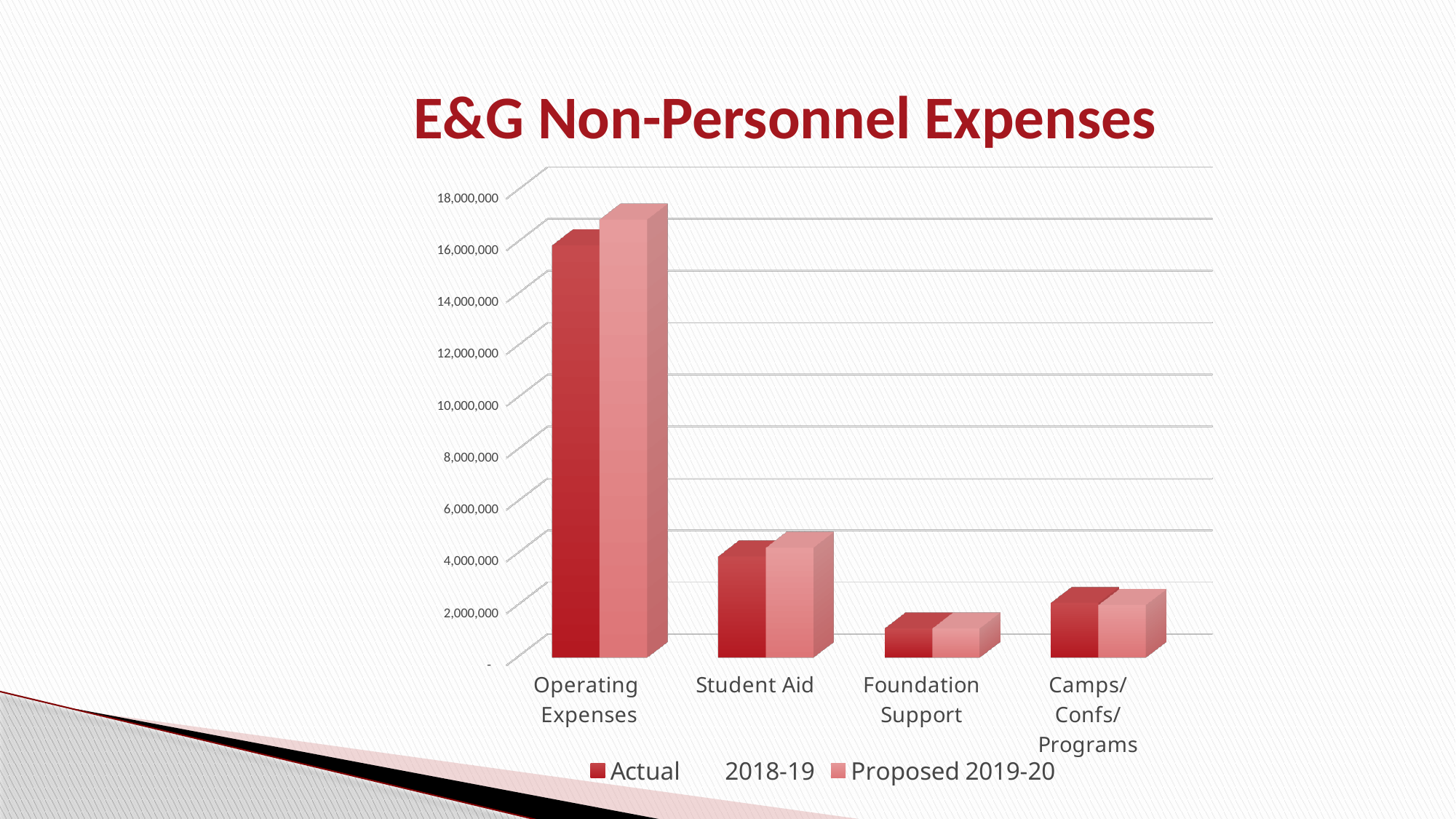
What is the title of the chart? E&G Non-Personnel Expenses Which category has the highest values in the chart? Operating Expenses Is the Actual 2018-19 value for Student Aid greater or less than 6,000,000? less Which category has the lowest values in the chart? Foundation Support Is the Proposed 2019-20 value for Camps/Confs/Programs greater or less than 4,000,000? less Is the Actual 2018-19 value for Foundation Support greater or less than 2,000,000? less How many expense categories are shown on the x axis? 4 What kind of chart is shown on the slide? Bar chart Which two series are listed in the legend? Actual 2018-19 and Proposed 2019-20 For Operating Expenses, which is larger: the Actual 2018-19 value or the Proposed 2019-20 value? Proposed 2019-20 How many series does the legend list? 2